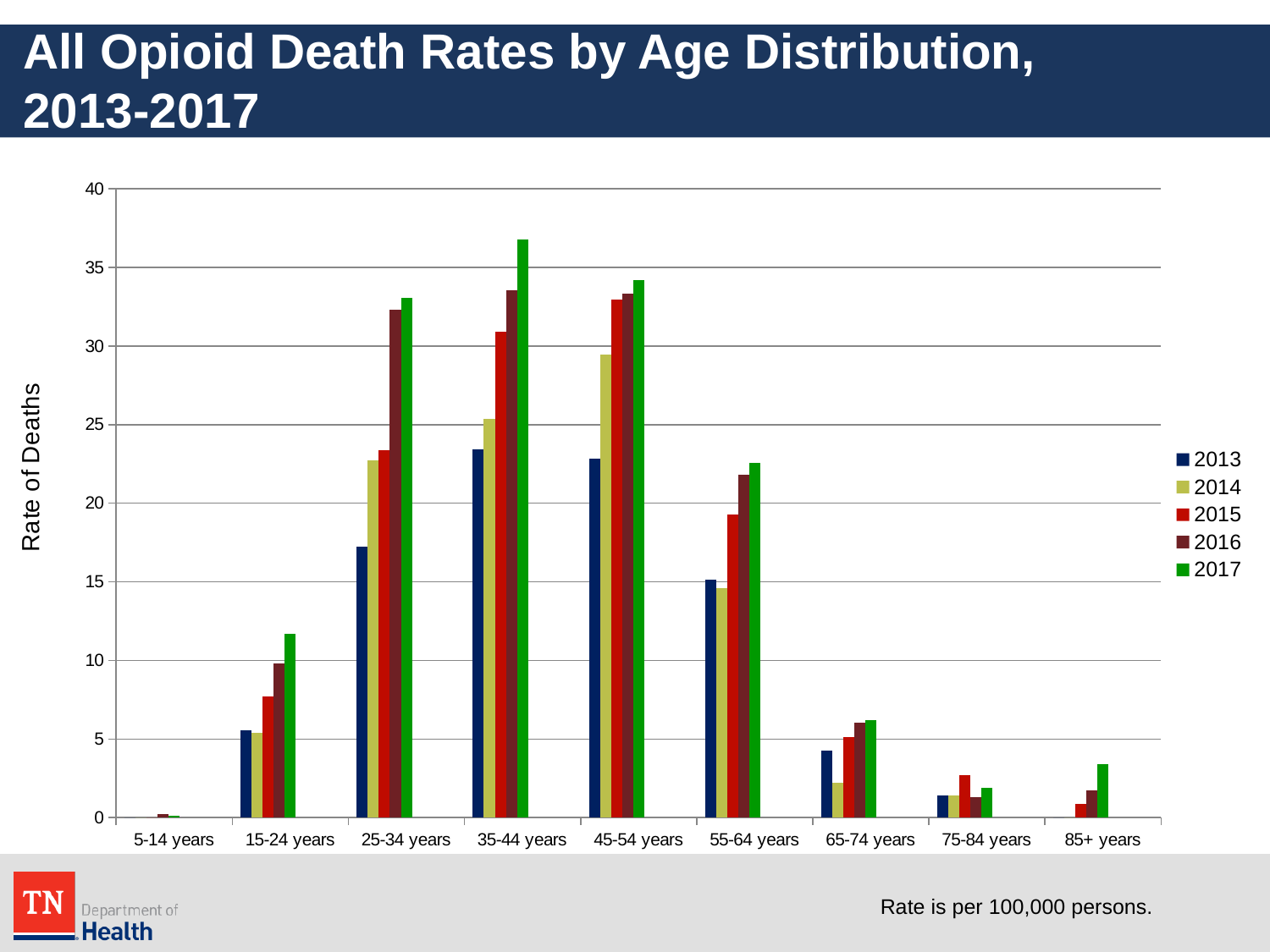
Is the 2016 value for 55-64 years greater or less than 20? greater How many series does the legend list? 5 What kind of chart is shown on the slide? bar chart How many age groups are shown on the x axis? 9 What colour represents 2017 in the legend? green Which is larger, the 2017 value for 15-24 years or the 2017 value for 65-74 years? 15-24 years Is the 2017 value for 35-44 years greater or less than 35? greater Which age group has the lowest bars across all years? 5-14 years For the 25-34 years group, do the values rise or fall from 2013 to 2017? rise Which age group has the highest 2017 bar? 35-44 years Is the 2013 value for 25-34 years greater or less than 15? greater What is the label on the y axis? Rate of Deaths